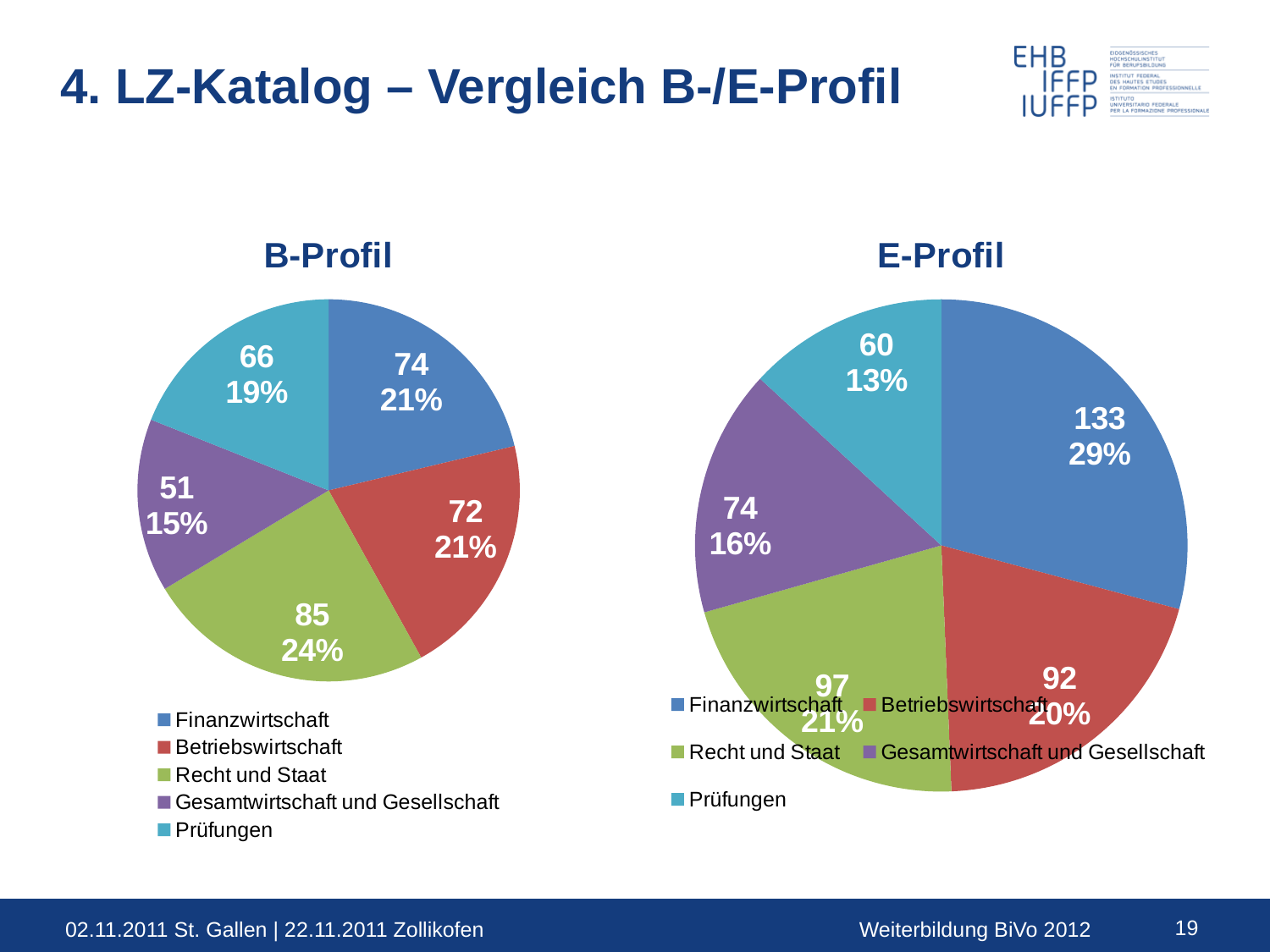
What type of chart is the E-Profil chart? Pie chart In the E-Profil chart, what percentage share does Prüfungen have? 13% In the E-Profil chart, which category is shown in purple? Gesamtwirtschaft und Gesellschaft In the B-Profil chart, what is the difference between the values for Recht und Staat and Gesamtwirtschaft und Gesellschaft? 34 In the B-Profil chart, what percentage share does Gesamtwirtschaft und Gesellschaft have? 15% How many categories does the B-Profil chart show? 5 In the B-Profil chart, which category has the largest slice? Recht und Staat In the B-Profil chart, what is the value for Recht und Staat? 85 In the E-Profil chart, what is the difference between the values for Finanzwirtschaft and Betriebswirtschaft? 41 In the E-Profil chart, which category has the smallest slice? Prüfungen In the E-Profil chart, what is the value for Finanzwirtschaft? 133 Which is larger: the value for Prüfungen in the B-Profil chart or in the E-Profil chart? B-Profil